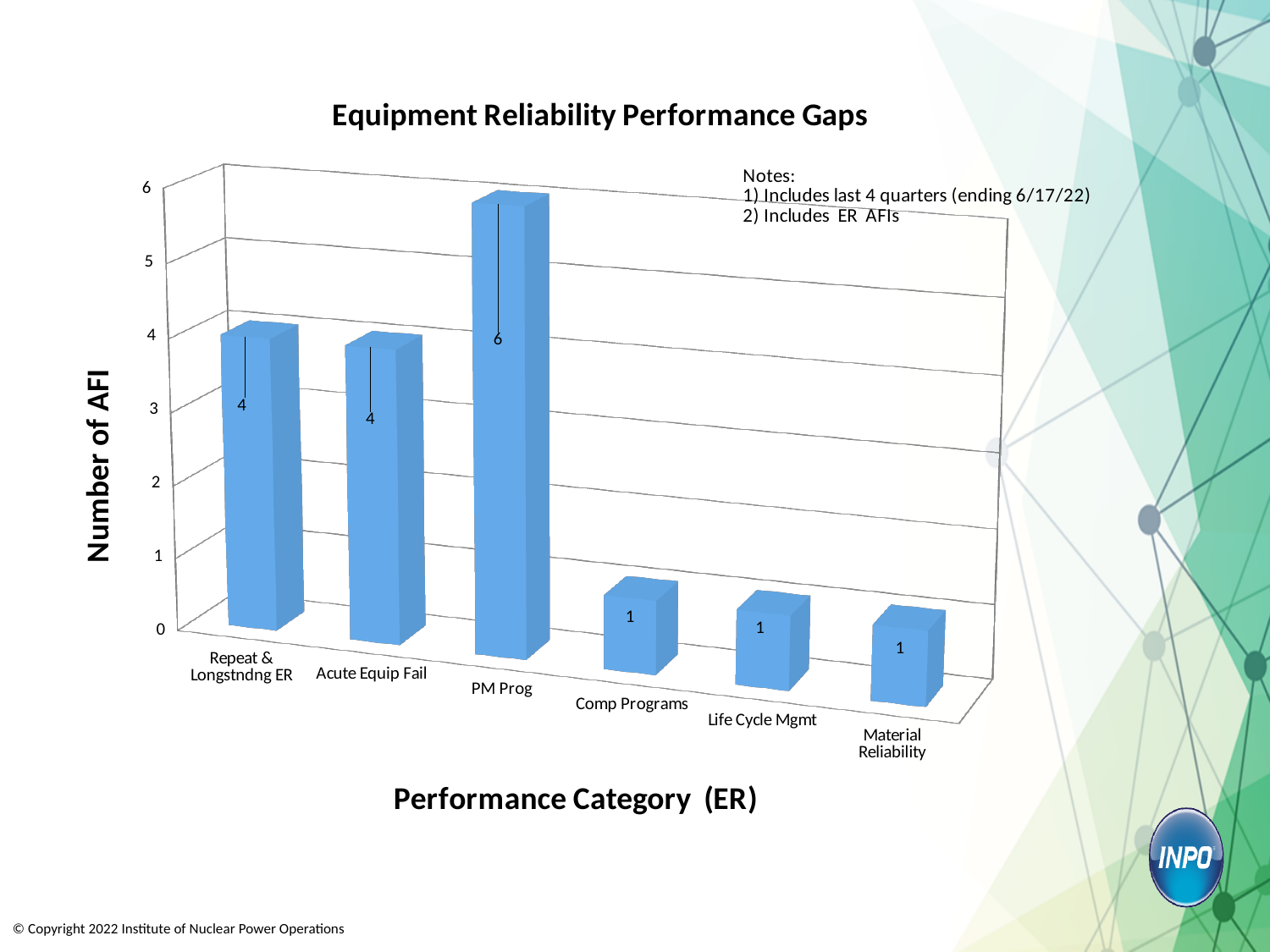
What is the difference between the values for PM Prog and Life Cycle Mgmt? 5 Which performance category has the highest number of AFI? PM Prog What is the value for Comp Programs? 1 How many performance categories are shown on the x axis? 6 What is the title of the chart? Equipment Reliability Performance Gaps What is the difference between the values for Acute Equip Fail and Material Reliability? 3 What is the value for Acute Equip Fail? 4 What is the value for PM Prog? 6 What is the value for Repeat & Longstndng ER? 4 Is the value for Life Cycle Mgmt greater or less than 3? less What kind of chart is shown on the slide? bar chart Which is larger, the value for PM Prog or the value for Repeat & Longstndng ER? PM Prog